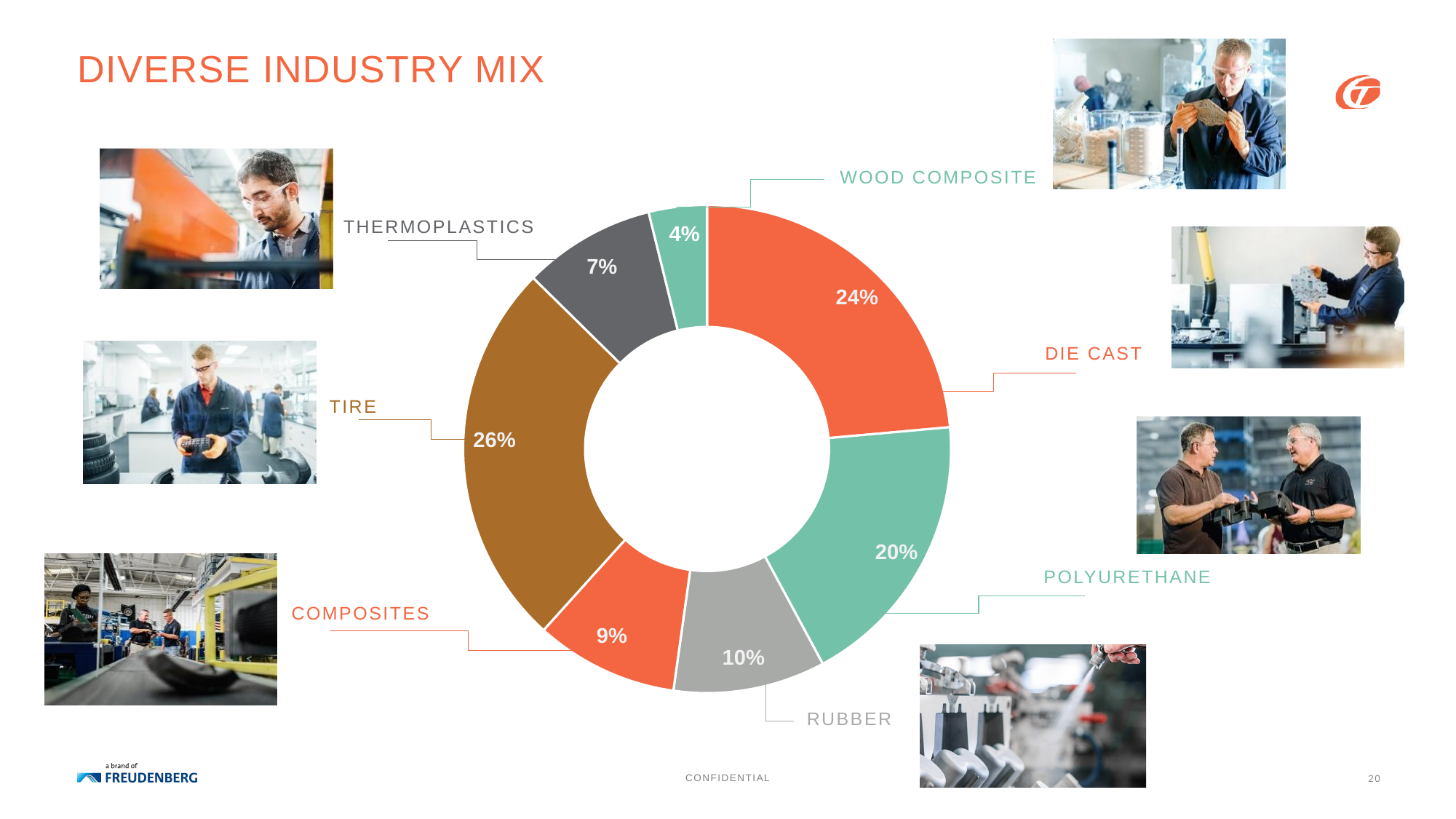
What is the combined share of Tire and Die Cast? 50% What is the title of the slide containing the chart? DIVERSE INDUSTRY MIX Which has a larger share, Composites or Thermoplastics? Composites What kind of chart is shown on the slide? Pie chart (donut) What share of the industry mix is Die Cast? 24% What share of the industry mix is Tire? 26% What percentage does Rubber account for? 10% Which industry has the largest share of the mix? Tire How many industry segments are shown in the chart? 7 Which industry has the smallest share of the mix? Wood Composite What is the difference in percentage points between Die Cast and Polyurethane? 4 What percentage does Wood Composite account for? 4%